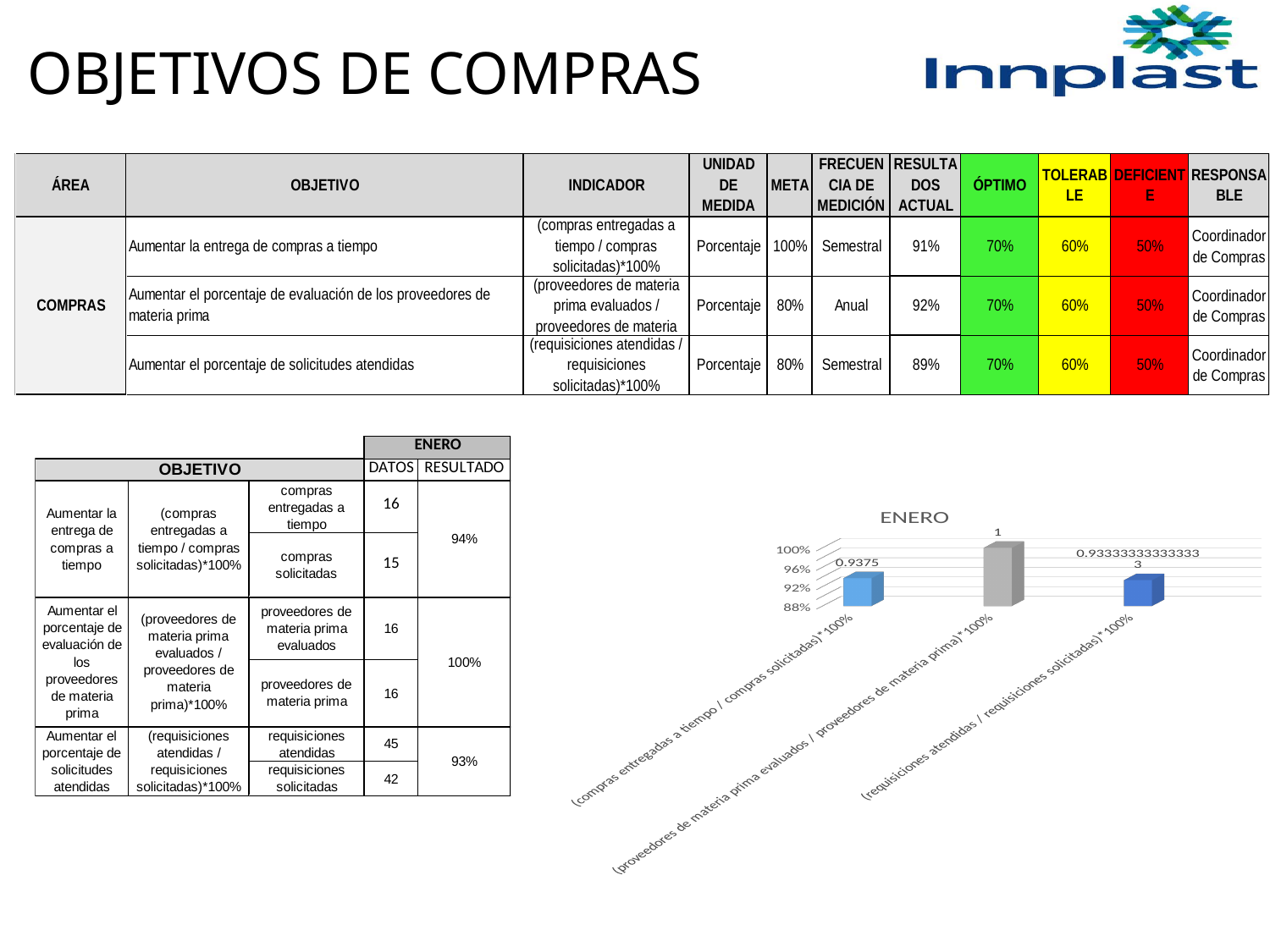
What is the title of the chart? ENERO Which category has the highest bar in the ENERO chart? (proveedores de materia prima evaluados / proveedores de materia prima)*100% What is the value of the bar for (compras entregadas a tiempo / compras solicitadas)*100% in the ENERO chart? 0.9375 What is the highest tick value shown on the vertical axis of the ENERO chart? 100% Is the value for (compras entregadas a tiempo / compras solicitadas)*100% greater or less than 92%? greater Which category has the lowest bar in the ENERO chart? (requisiciones atendidas / requisiciones solicitadas)*100% How many bars does the ENERO chart show? 3 What is the value of the bar for (requisiciones atendidas / requisiciones solicitadas)*100% in the ENERO chart? 0.93333333333333 Which is larger in the ENERO chart: the bar for (compras entregadas a tiempo / compras solicitadas)*100% or the bar for (requisiciones atendidas / requisiciones solicitadas)*100%? (compras entregadas a tiempo / compras solicitadas)*100% What is the difference between the bar for (proveedores de materia prima evaluados / proveedores de materia prima)*100% and the bar for (compras entregadas a tiempo / compras solicitadas)*100%? 0.0625 What is the value of the bar for (proveedores de materia prima evaluados / proveedores de materia prima)*100% in the ENERO chart? 1 What kind of chart is shown on the slide? bar chart